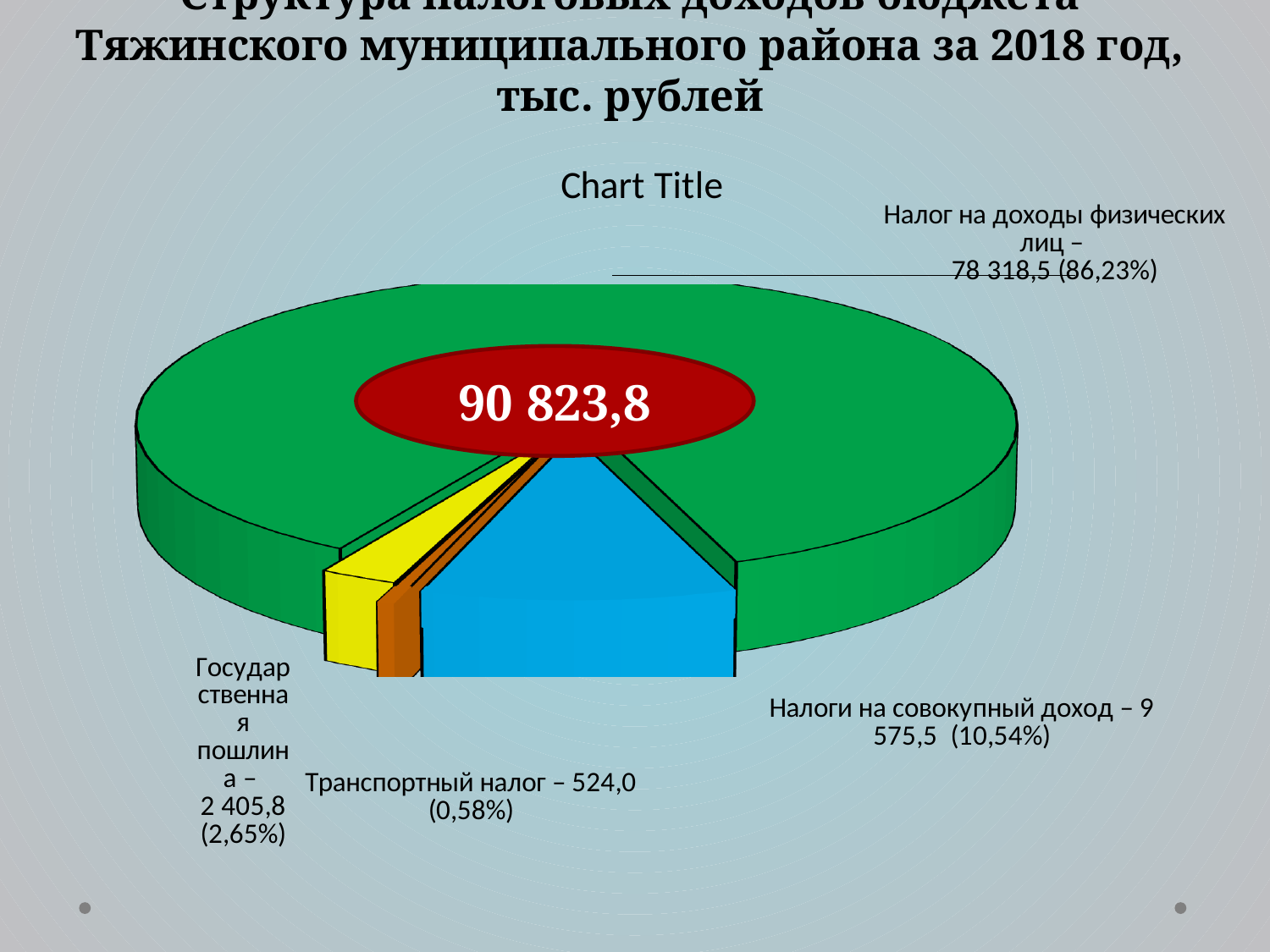
What is the value for Налог на доходы физических лиц? 78 318,5 What is the value for Транспортный налог? 524,0 What share of the pie does Налоги на совокупный доход represent? 10,54% What share of the pie does Государственная пошлина represent? 2,65% Which is larger, Государственная пошлина or Транспортный налог? Государственная пошлина What total value is printed in the centre of the pie chart? 90 823,8 How many slices does the pie chart have? 4 What kind of chart is shown on the slide? pie chart Which category has the largest slice of the pie? Налог на доходы физических лиц What is the value for Государственная пошлина? 2 405,8 What is the value for Налоги на совокупный доход? 9 575,5 Which category has the smallest slice of the pie? Транспортный налог